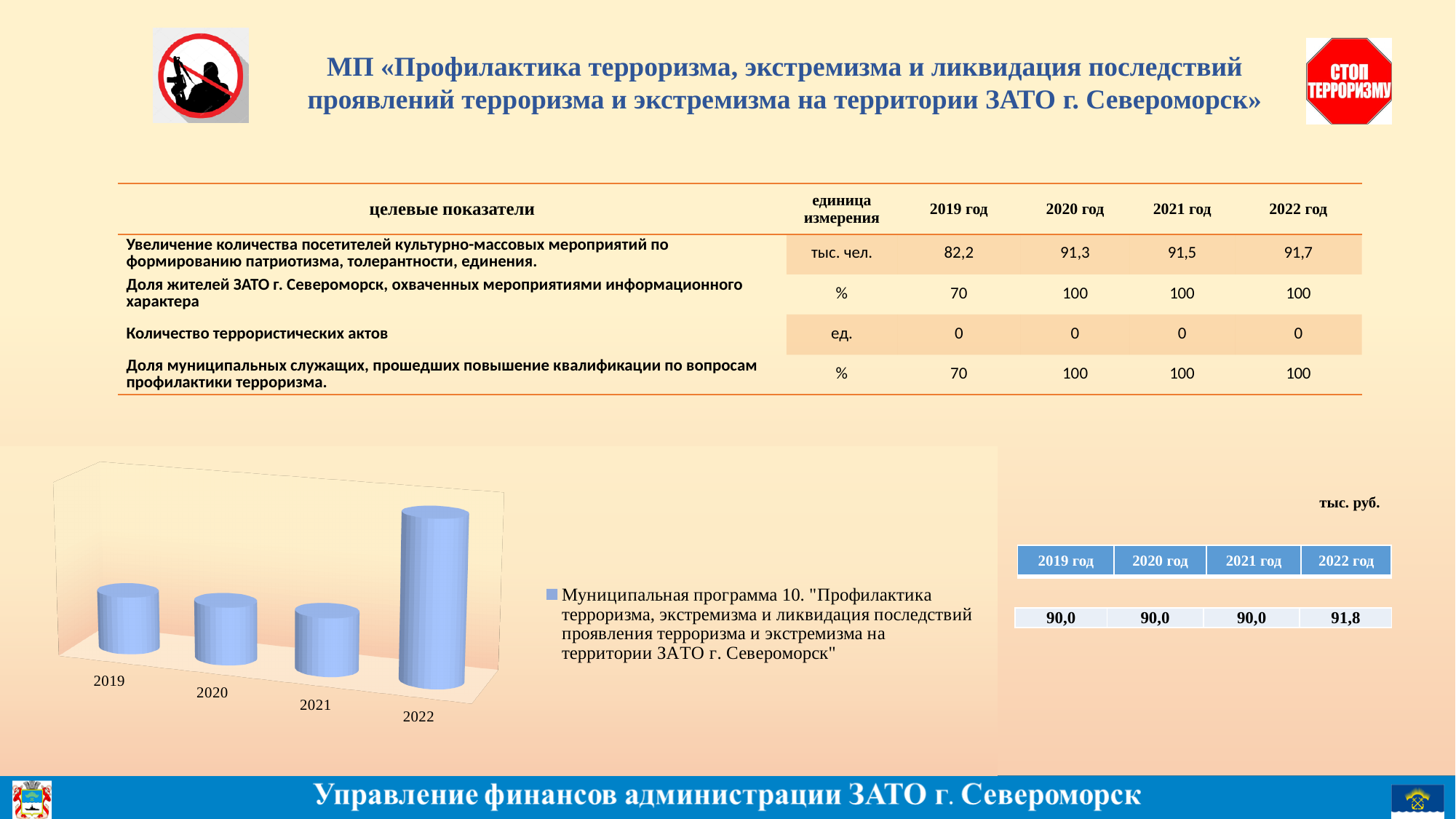
Which year has the tallest bar in the bar chart? 2022 In the bar chart, which bar is taller: 2022 or 2021? 2022 What is the first year shown on the x axis of the bar chart? 2019 How many categories (years) are shown on the x axis of the bar chart? 4 What is the last year shown on the x axis of the bar chart? 2022 How many series does the legend of the bar chart list? 1 What kind of chart is shown at the bottom left of the slide? bar chart In the bar chart, which bar is taller: 2022 or 2019? 2022